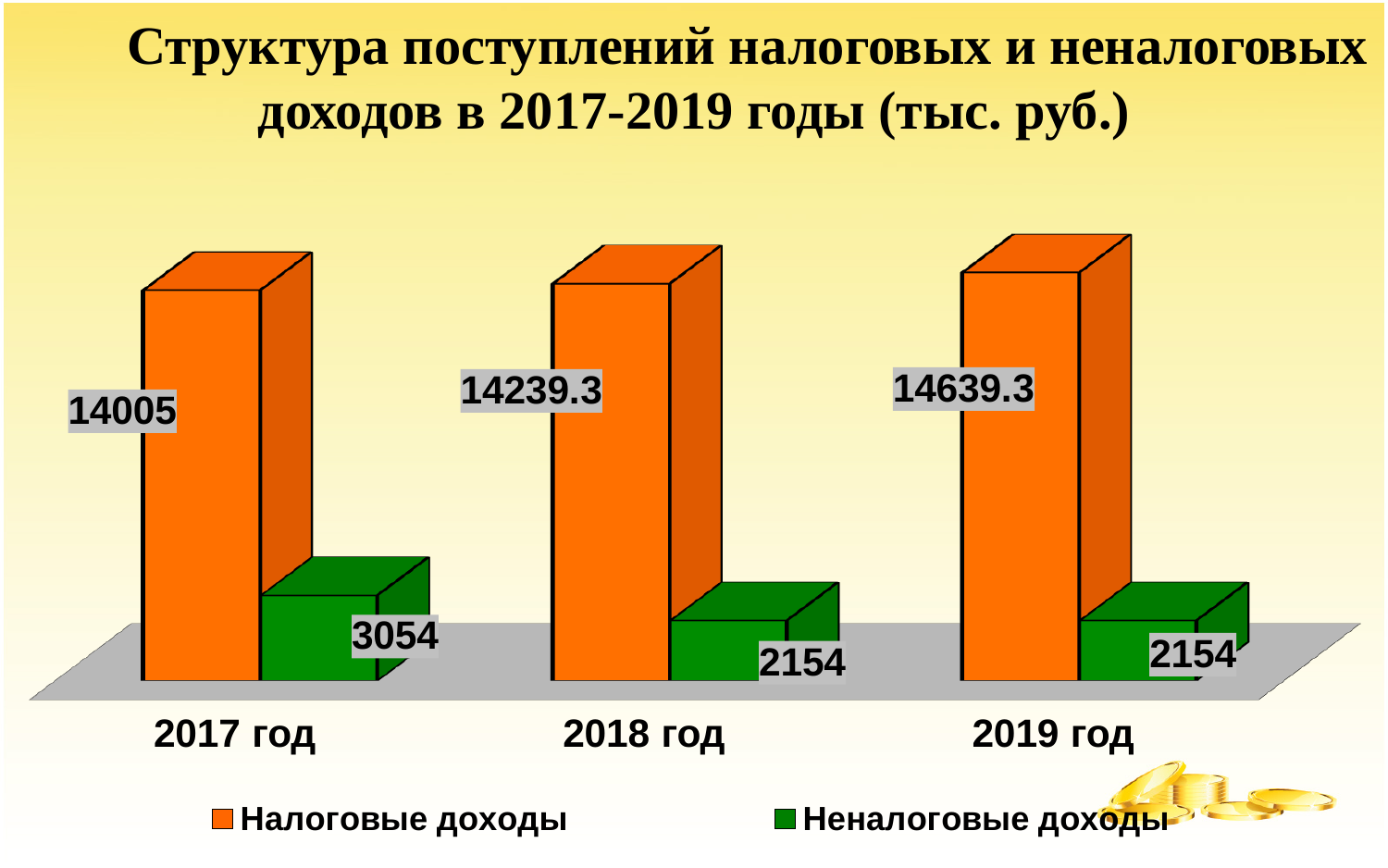
What is the difference between Налоговые доходы in 2019 год and 2018 год? 400 What is the value of Налоговые доходы for 2017 год? 14005 What is the value of Неналоговые доходы for 2018 год? 2154 Which year has the highest value for Неналоговые доходы? 2017 год What is the difference between Неналоговые доходы in 2017 год and 2018 год? 900 What is the value of Налоговые доходы for 2019 год? 14639.3 Do the values for Налоговые доходы rise or fall from 2017 год to 2019 год? Rise Which year has the highest value for Налоговые доходы? 2019 год How many series does the legend list? 2 How many years are shown on the x axis? 3 What kind of chart is shown on the slide? Bar chart Which is larger: Налоговые доходы in 2018 год or in 2017 год? 2018 год